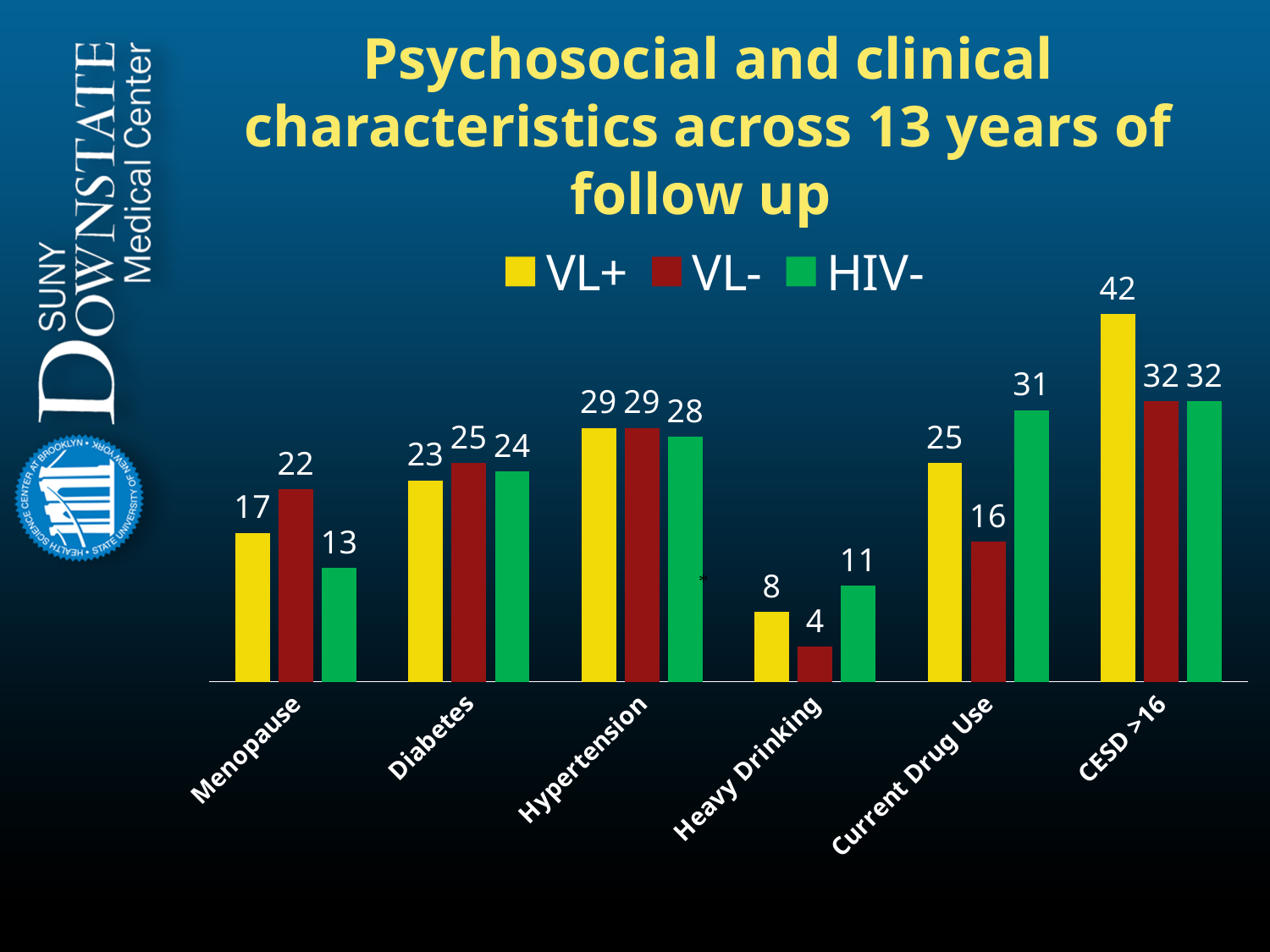
Which colour represents the HIV- series in the legend? Green What kind of chart is shown on the slide? Bar chart What is the difference between the VL+ and VL- values for CESD >16? 10 Which category has the lowest VL- value? Heavy Drinking Which category has the highest VL+ value? CESD >16 How many series does the legend list? 3 What is the VL- value for Current Drug Use? 16 What is the HIV- value for Heavy Drinking? 11 How many categories are shown on the x axis? 6 Which is larger for Menopause, the VL- value or the HIV- value? VL- What is the difference between the HIV- values for Current Drug Use and Heavy Drinking? 20 What is the VL+ value for Menopause? 17